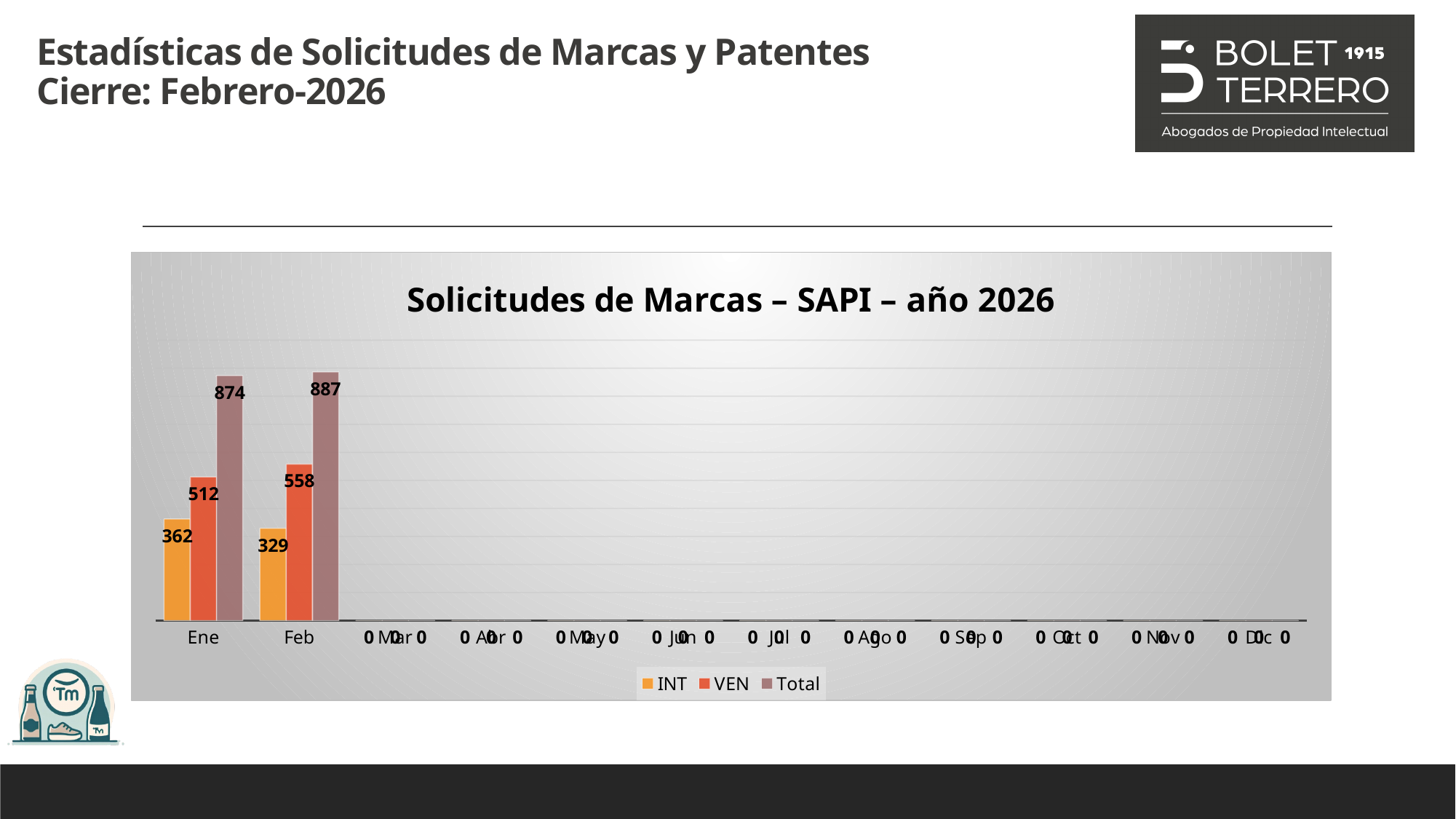
What kind of chart is shown? Bar chart What is the title of the chart? Solicitudes de Marcas – SAPI – año 2026 What is the Total value for Feb? 887 What is the difference between the INT values for Ene and Feb? 33 Which month has the higher Total value, Ene or Feb? Feb How many months are shown on the x axis? 12 What is the Total value for Ene? 874 What is the VEN value for Feb? 558 Which month has the higher INT value, Ene or Feb? Ene What is the difference between the VEN values for Feb and Ene? 46 What is the INT value for Ene? 362 How many series does the legend list? 3